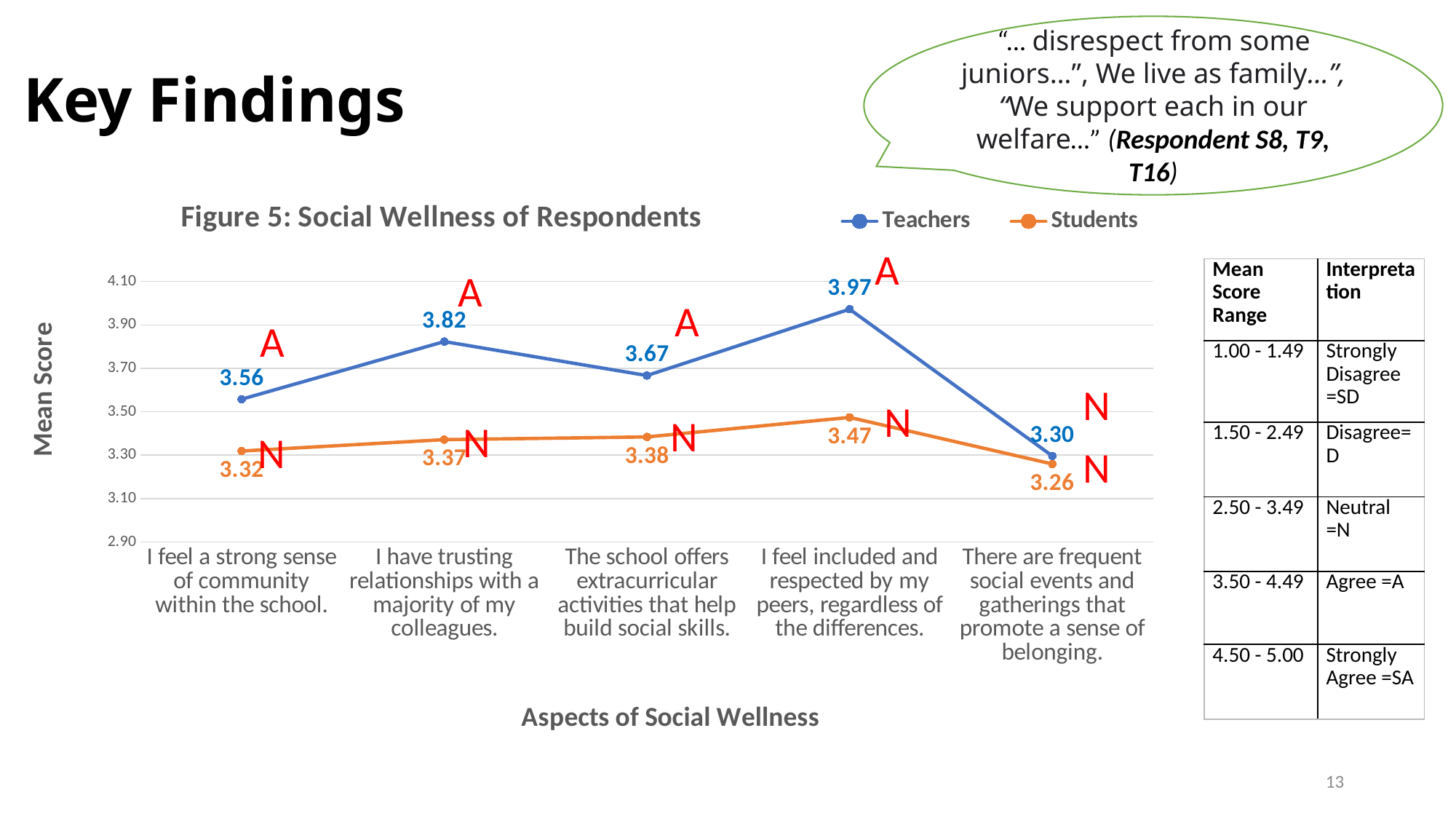
What is the title of the chart? Figure 5: Social Wellness of Respondents How many series does the legend list? 2 For 'The school offers extracurricular activities that help build social skills.', which group has the higher mean score, Teachers or Students? Teachers Does the Teachers line rise or fall between 'I feel included and respected by my peers, regardless of the differences.' and 'There are frequent social events and gatherings that promote a sense of belonging.'? Fall Which aspect has the highest Teachers mean score? I feel included and respected by my peers, regardless of the differences. Which aspect has the lowest Students mean score? There are frequent social events and gatherings that promote a sense of belonging. What is the Teachers mean score for 'I feel included and respected by my peers, regardless of the differences.'? 3.97 What is the Teachers mean score for 'There are frequent social events and gatherings that promote a sense of belonging.'? 3.30 What is the Students mean score for 'I have trusting relationships with a majority of my colleagues.'? 3.37 What is the difference between the Teachers and Students mean scores for 'I feel a strong sense of community within the school.'? 0.24 How many aspects of social wellness are plotted on the x axis? 5 What kind of chart is Figure 5? Line chart